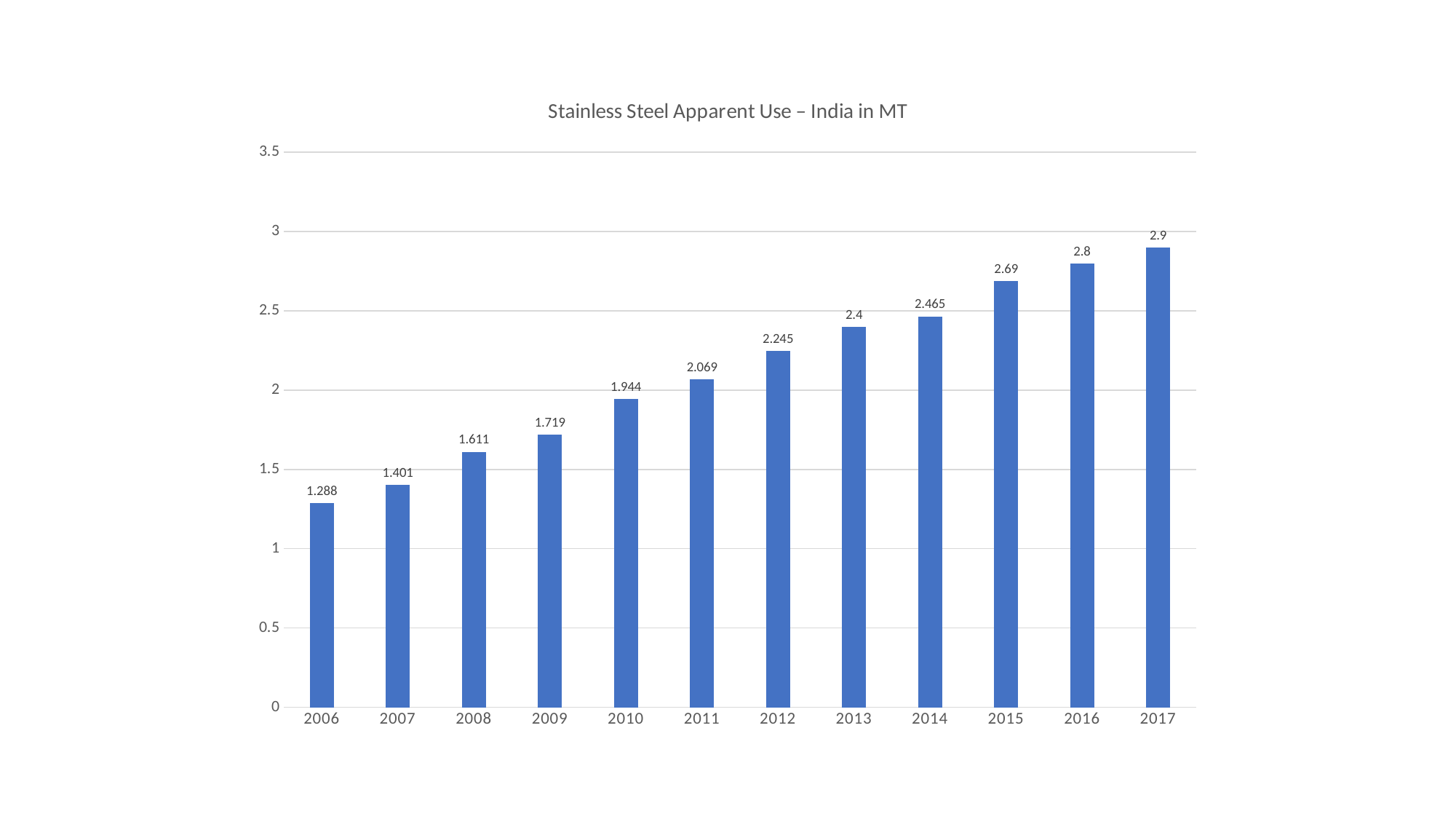
Is the value for 2015 greater or less than 2.5? greater What is the value for 2006? 1.288 What is the value for 2014? 2.465 Do the values rise or fall from 2006 to 2017? rise What is the difference between the values for 2017 and 2006? 1.612 Which is larger, the value for 2009 or the value for 2011? 2011 Which year has the highest value? 2017 What is the value for 2010? 1.944 How many years are shown on the x axis? 12 Which year has the lowest value? 2006 What is the difference between the values for 2013 and 2012? 0.155 What kind of chart is this? bar chart